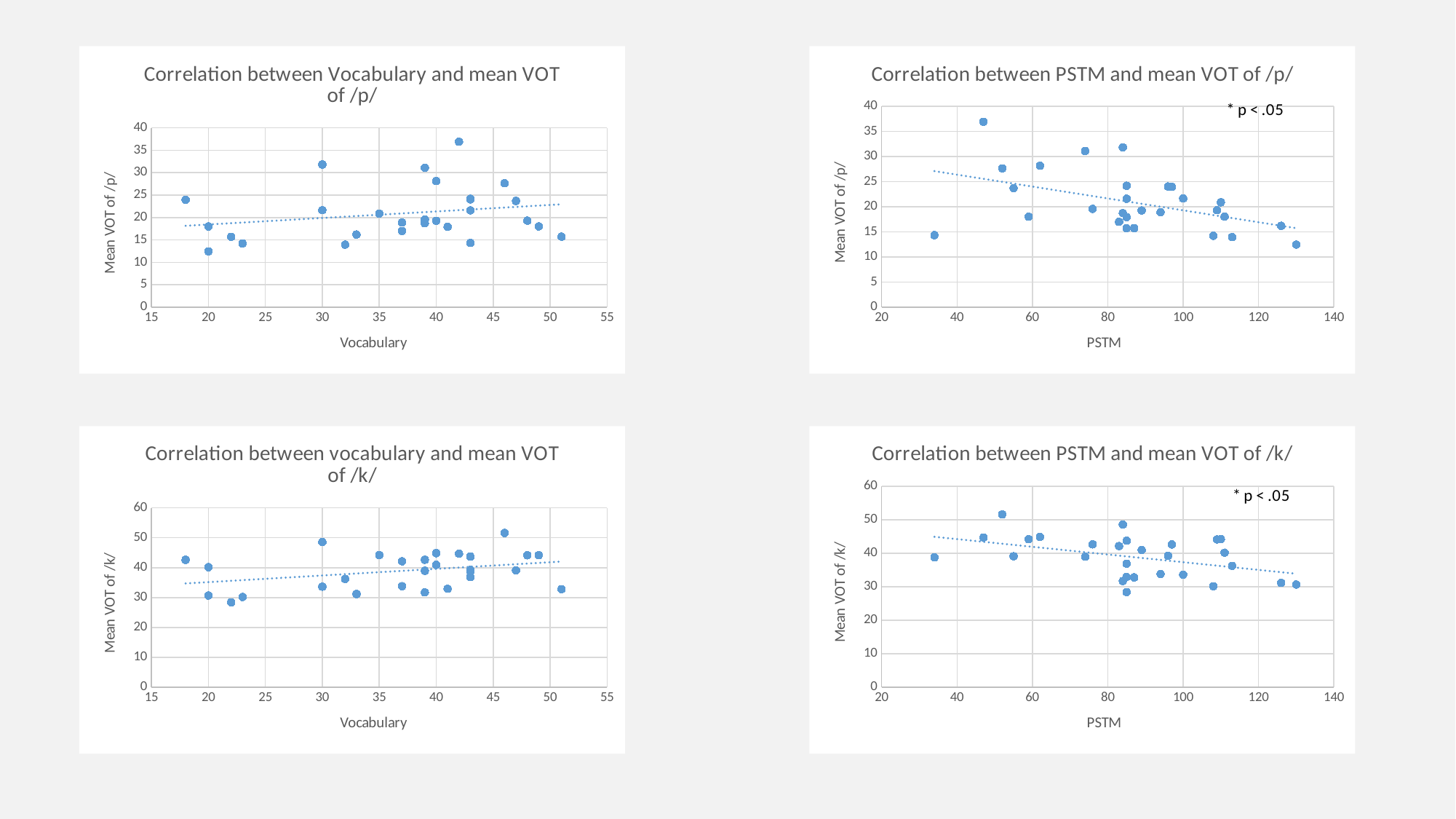
In the top-left chart (Vocabulary vs mean VOT of /p/), is the highest plotted point greater or less than 35? greater In the bottom-left chart (vocabulary vs mean VOT of /k/), does the dotted trend line rise or fall as Vocabulary increases? Rises How many charts are shown on the slide? 4 In the bottom-left chart (vocabulary vs mean VOT of /k/), is the highest plotted point greater or less than 50? greater In the top-right chart (PSTM vs mean VOT of /p/), does the dotted trend line rise or fall as PSTM increases? Falls In the top-left chart (Vocabulary vs mean VOT of /p/), does the dotted trend line rise or fall as Vocabulary increases? Rises What is the x-axis title of the top-right chart titled "Correlation between PSTM and mean VOT of /p/"? PSTM What kind of chart is the top-left chart titled "Correlation between Vocabulary and mean VOT of /p/"? Scatter chart In the bottom-right chart (PSTM vs mean VOT of /k/), is the lowest plotted point greater or less than 30? less Which two charts on the slide carry the annotation "* p < .05"? The two PSTM charts (top-right and bottom-right)